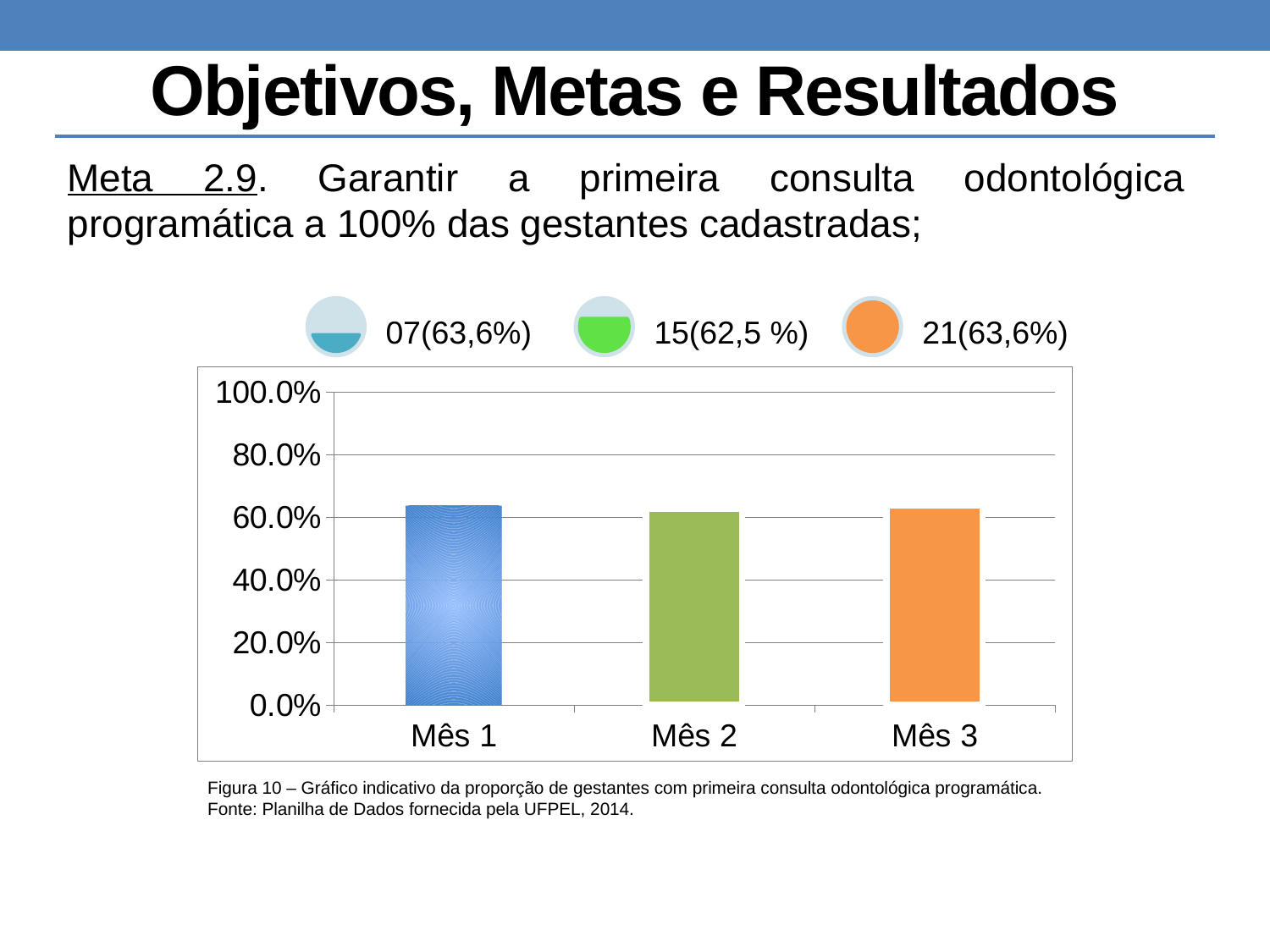
Is the value for Mês 1 greater or less than 40.0%? greater What is the label of the category plotted with the orange bar? Mês 3 According to the label above the chart, what is the value shown for Mês 3 (orange)? 21(63,6%) What percentage is shown for Mês 2 in the label above the chart? 62,5 % Is the value for Mês 3 greater or less than 80.0%? less What kind of chart is shown on the slide? bar chart Is the value for Mês 2 greater or less than 100.0%? less According to the label above the chart, what is the value shown for Mês 1 (blue)? 07(63,6%) Using the printed percentages, what is the difference between the value for Mês 1 (63,6%) and Mês 2 (62,5%)? 1,1% How many categories (months) are plotted on the chart? 3 What is the highest value shown on the vertical axis? 100.0% According to the label above the chart, what is the value shown for Mês 2 (green)? 15(62,5 %)